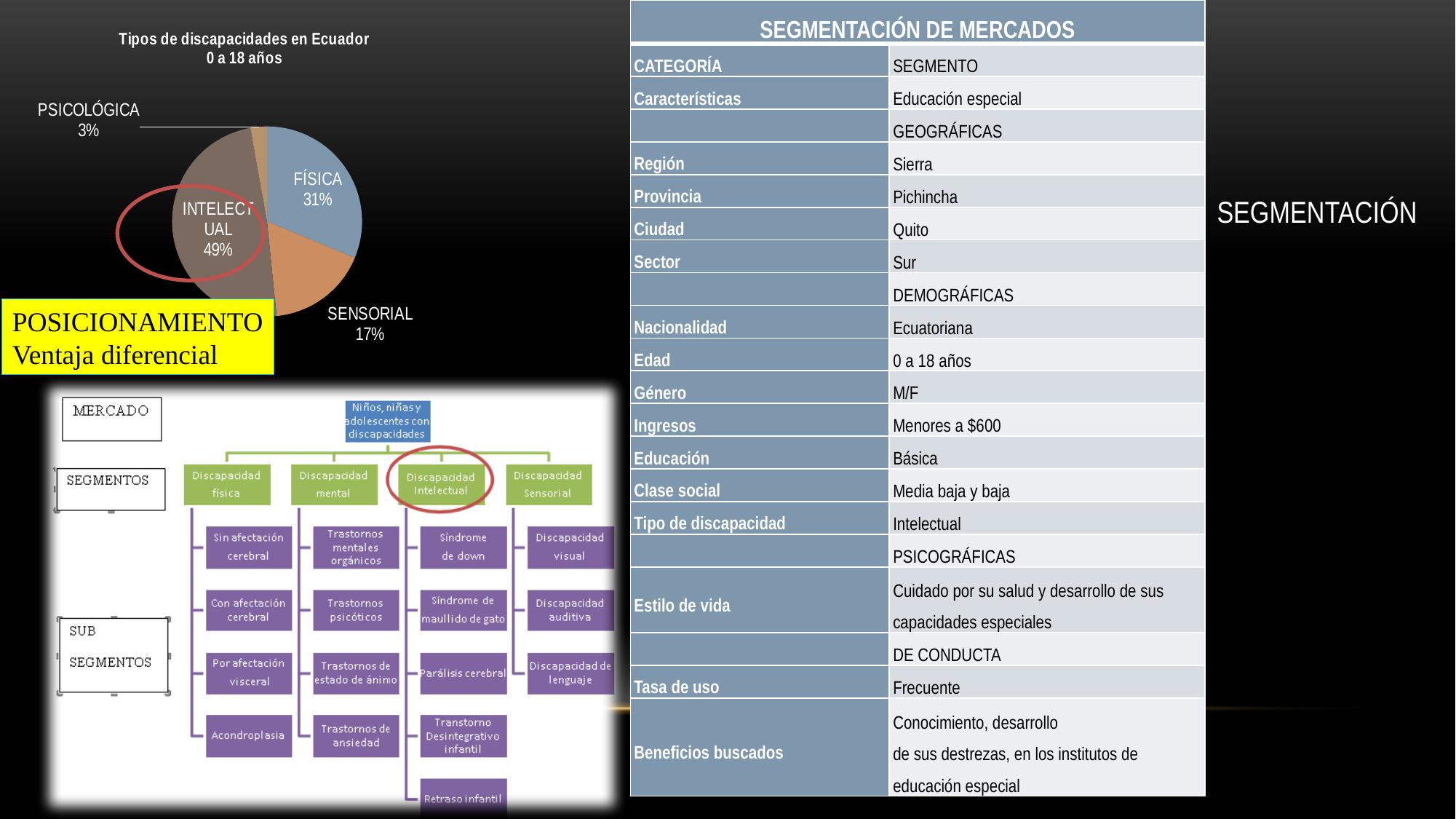
In the pie chart, what is the difference in percentage points between INTELECTUAL and FÍSICA? 18 In the pie chart, what percentage is shown for FÍSICA? 31% Which category has the largest slice in the pie chart? INTELECTUAL In the pie chart, what share does INTELECTUAL have? 49% What is the title of the pie chart? Tipos de discapacidades en Ecuador 0 a 18 años How many categories does the pie chart show? 4 In the pie chart, which is larger: FÍSICA or SENSORIAL? FÍSICA What type of chart is "Tipos de discapacidades en Ecuador 0 a 18 años"? Pie chart In the pie chart, what percentage is shown for PSICOLÓGICA? 3% In the pie chart, what percentage is shown for SENSORIAL? 17% Which category has the smallest slice in the pie chart? PSICOLÓGICA In the pie chart, what is the difference in percentage points between SENSORIAL and PSICOLÓGICA? 14